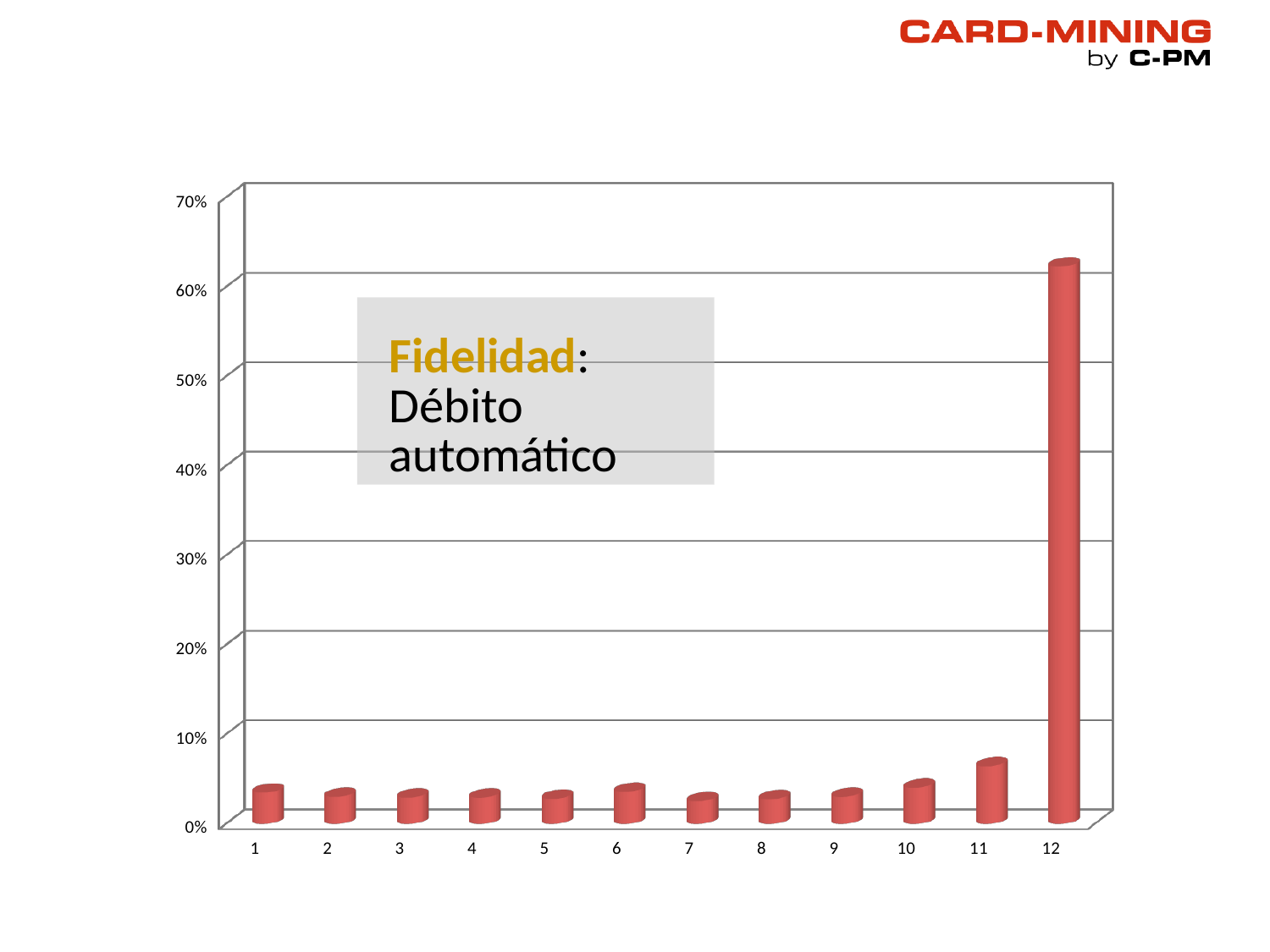
Which is larger, the value for category 11 or the value for category 1? 11 What text appears in the box overlaid on the chart? Fidelidad: Débito automático Is the value for category 1 greater or less than 10%? less Which category has the highest value in the chart? 12 Is the value for category 11 greater or less than 10%? less What kind of chart is shown on the slide? bar chart Is the value for category 12 greater or less than 70%? less How many categories are shown on the x axis of the chart? 12 What is the highest value shown on the y axis of the chart? 70% Which is larger, the value for category 11 or the value for category 12? 12